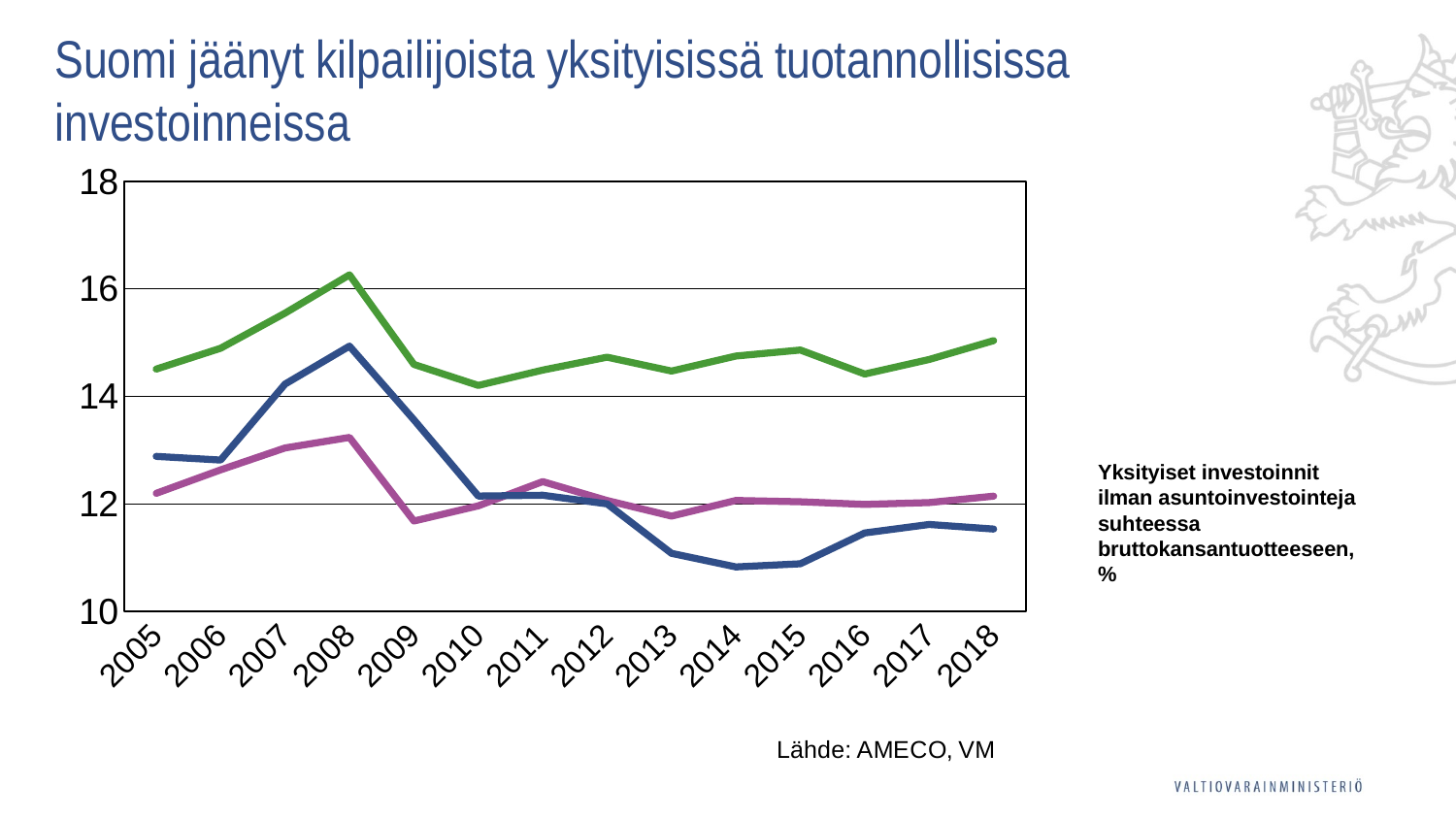
Is the value of the green line in 2008 greater or less than 16? greater In which year does the green line reach its highest value? 2008 In 2018, which line has the higher value, the green line or the blue line? green line Does the blue line rise or fall between 2008 and 2014? fall Is the value of the purple line in 2009 greater or less than 12? less What kind of chart is shown on the slide? line chart Is the value of the blue line in 2014 greater or less than 12? less In which year does the blue line reach its highest value? 2008 In which year does the blue line reach its lowest value? 2014 How many years are shown on the x axis of the chart? 14 What source is cited below the chart? AMECO, VM How many lines are plotted on the chart? 3